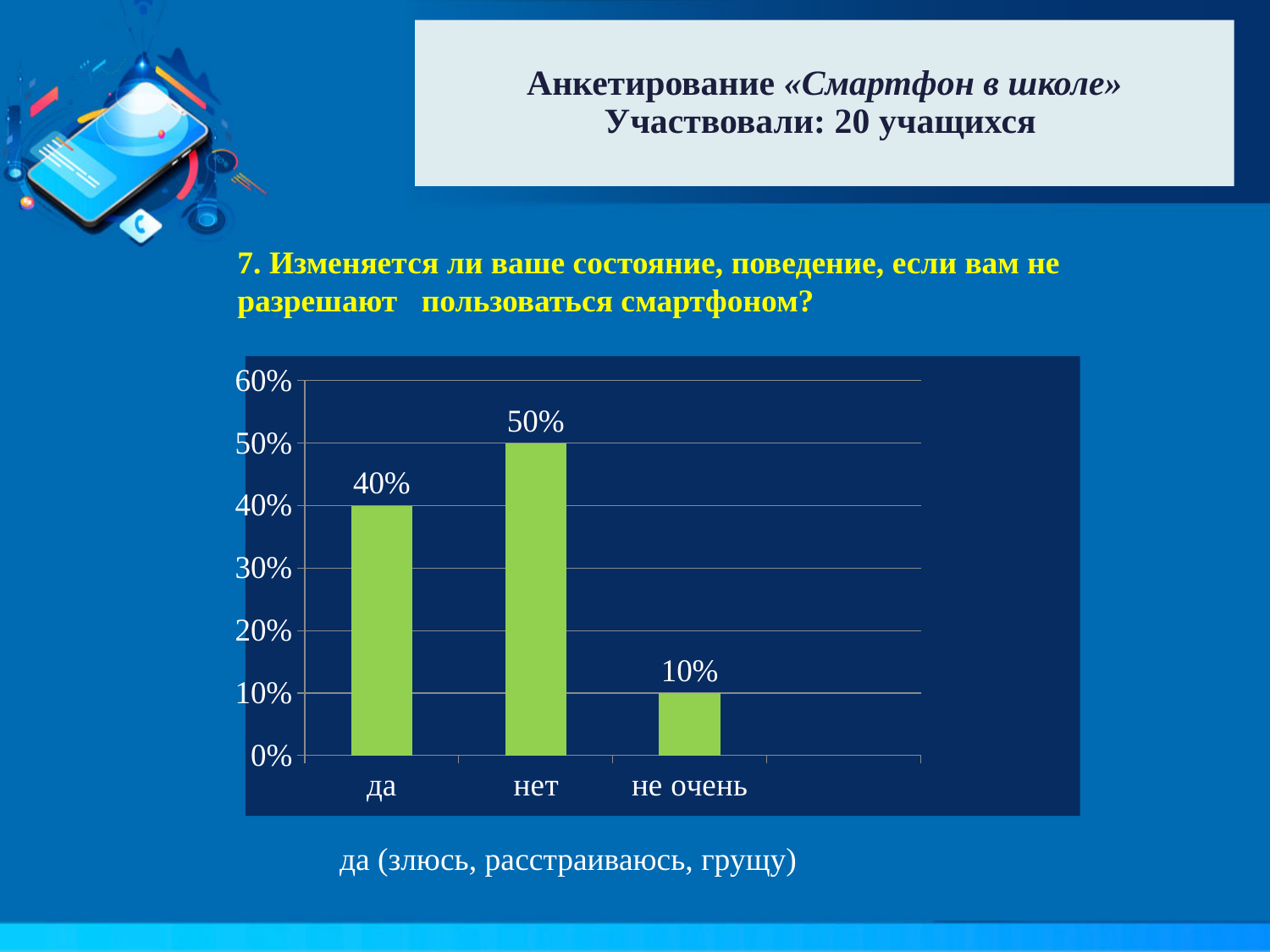
What is the difference between the values for "да" and "не очень"? 30% Which category has the highest value? нет How many categories are shown on the x axis? 3 What is the difference between the values for "нет" and "да"? 10% What is the value for "не очень"? 10% Is the value for "нет" greater or less than 30%? greater Which is larger, the value for "да" or the value for "не очень"? да What is the value for "нет"? 50% What kind of chart is shown on the slide? bar chart Which category has the lowest value? не очень What is the value for "да"? 40% What colour are the bars in the chart? green